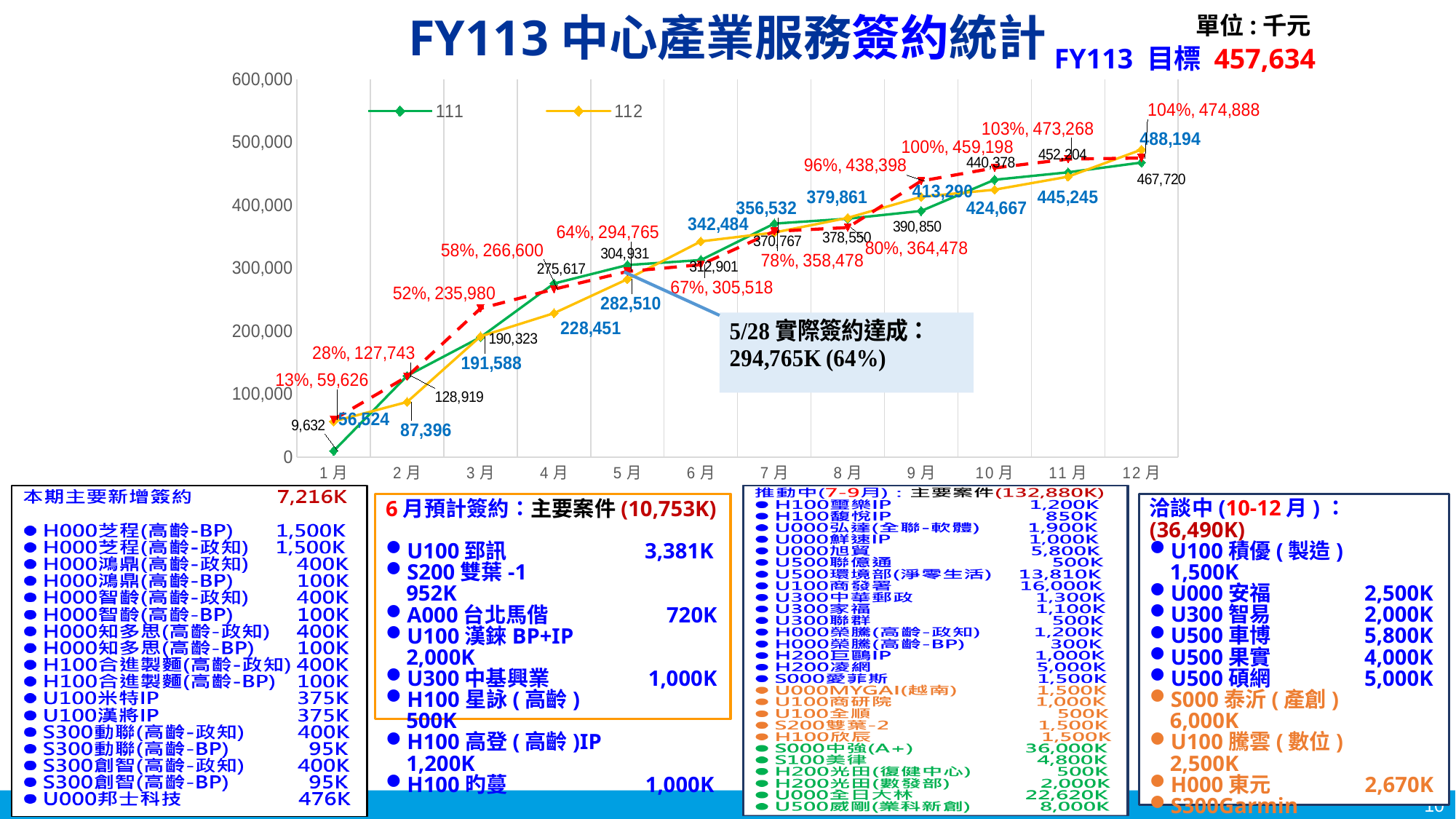
What is the value of series 112 in 12月? 488,194 In 4月, which series has the larger value, 111 or 112? 111 How many months are shown on the x axis of the chart? 12 How many series does the chart legend list? 2 What kind of chart is shown on the slide? line chart What is the value of series 111 in 5月? 304,931 Do the values of series 111 generally rise or fall from 1月 to 12月? rise What is the difference between series 112 and series 111 in 12月? 20,474 In which month does series 112 reach its highest value? 12月 What is the value of series 112 in 9月? 413,290 In which month is series 111 at its lowest value? 1月 What is the value of series 111 in 12月? 467,720